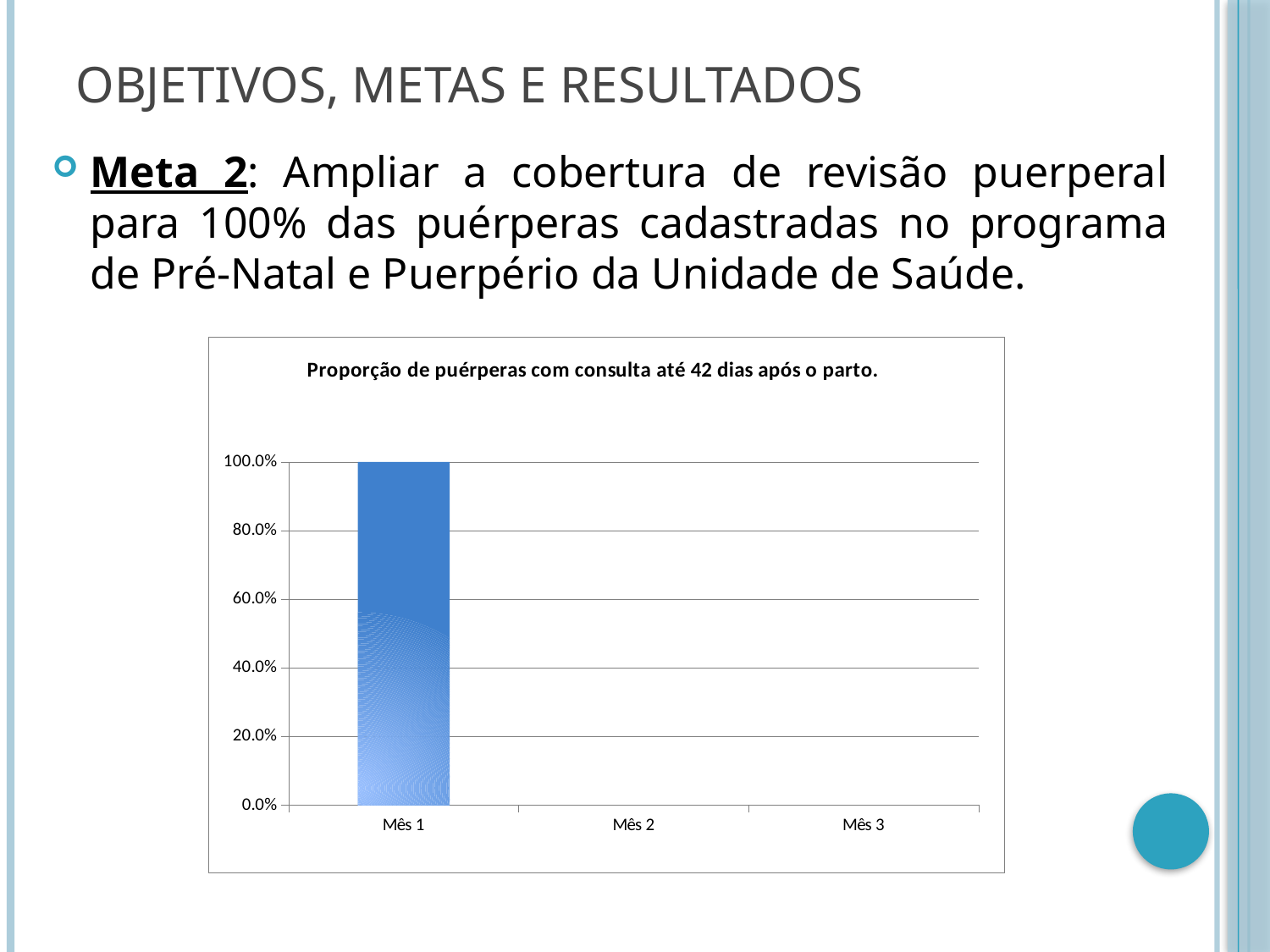
What is the highest value shown on the y axis of the chart? 100.0% How many categories are shown on the x axis of the chart? 3 Is the value for Mês 1 greater or less than 80.0%? greater What is the title of the chart? Proporção de puérperas com consulta até 42 dias após o parto. What is the label of the first category on the x axis? Mês 1 What kind of chart is shown on the slide? bar chart Which category has the highest value in the chart? Mês 1 What is the label of the last category on the x axis? Mês 3 What is the value for Mês 1 in the chart? 100.0% How many categories in the chart have a visible bar? 1